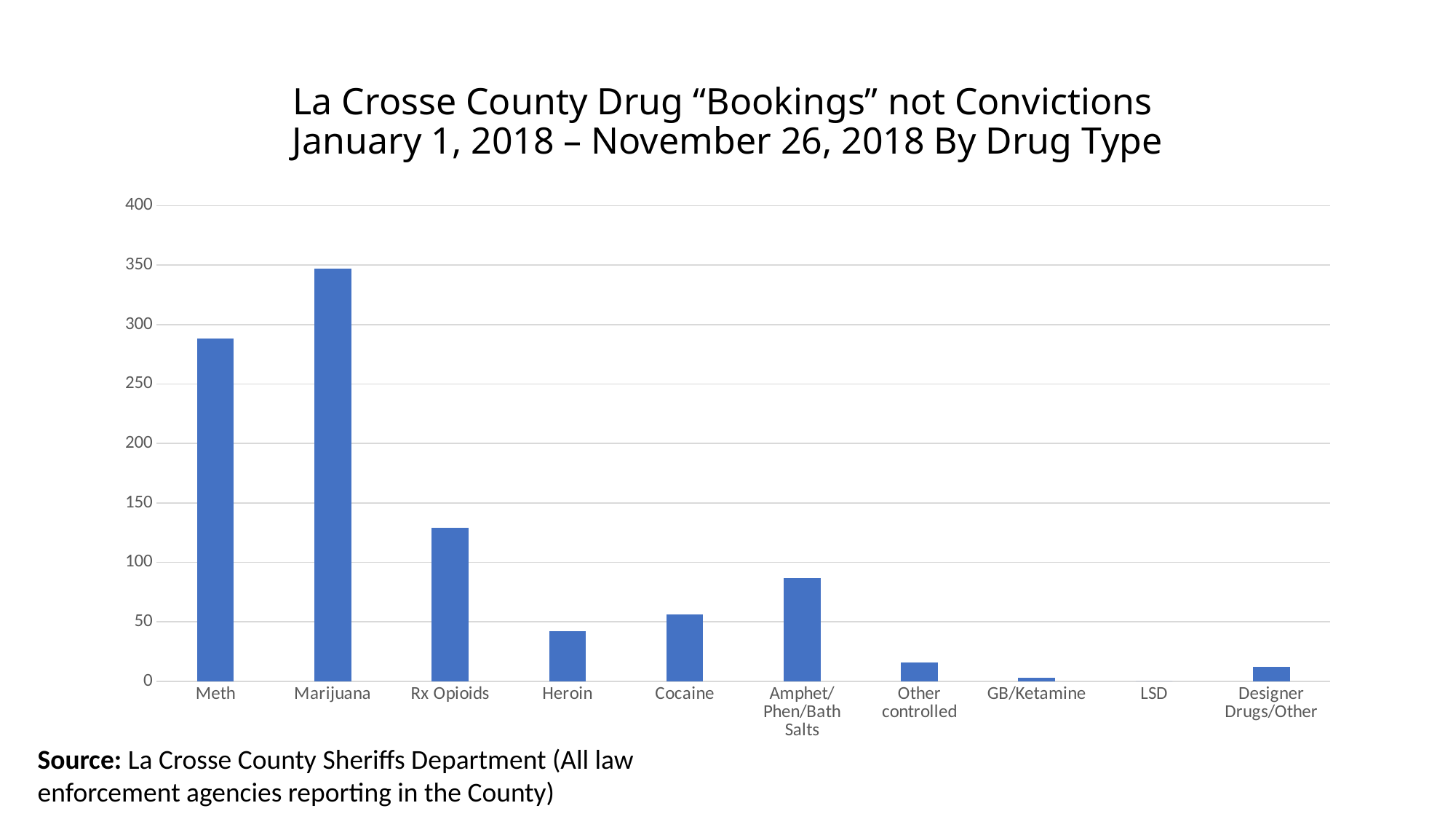
Which drug type has the lowest number of bookings? LSD Is the value for Meth greater or less than 250? greater Is the value for Marijuana greater or less than 300? greater Is the value for Rx Opioids greater or less than 100? greater Which has more bookings, Meth or Marijuana? Marijuana Which has more bookings, Cocaine or Heroin? Cocaine Which drug type has the highest number of bookings? Marijuana What is the source of the data cited on the slide? La Crosse County Sheriffs Department How many drug type categories are shown on the x axis? 10 What kind of chart is shown on the slide? Bar chart